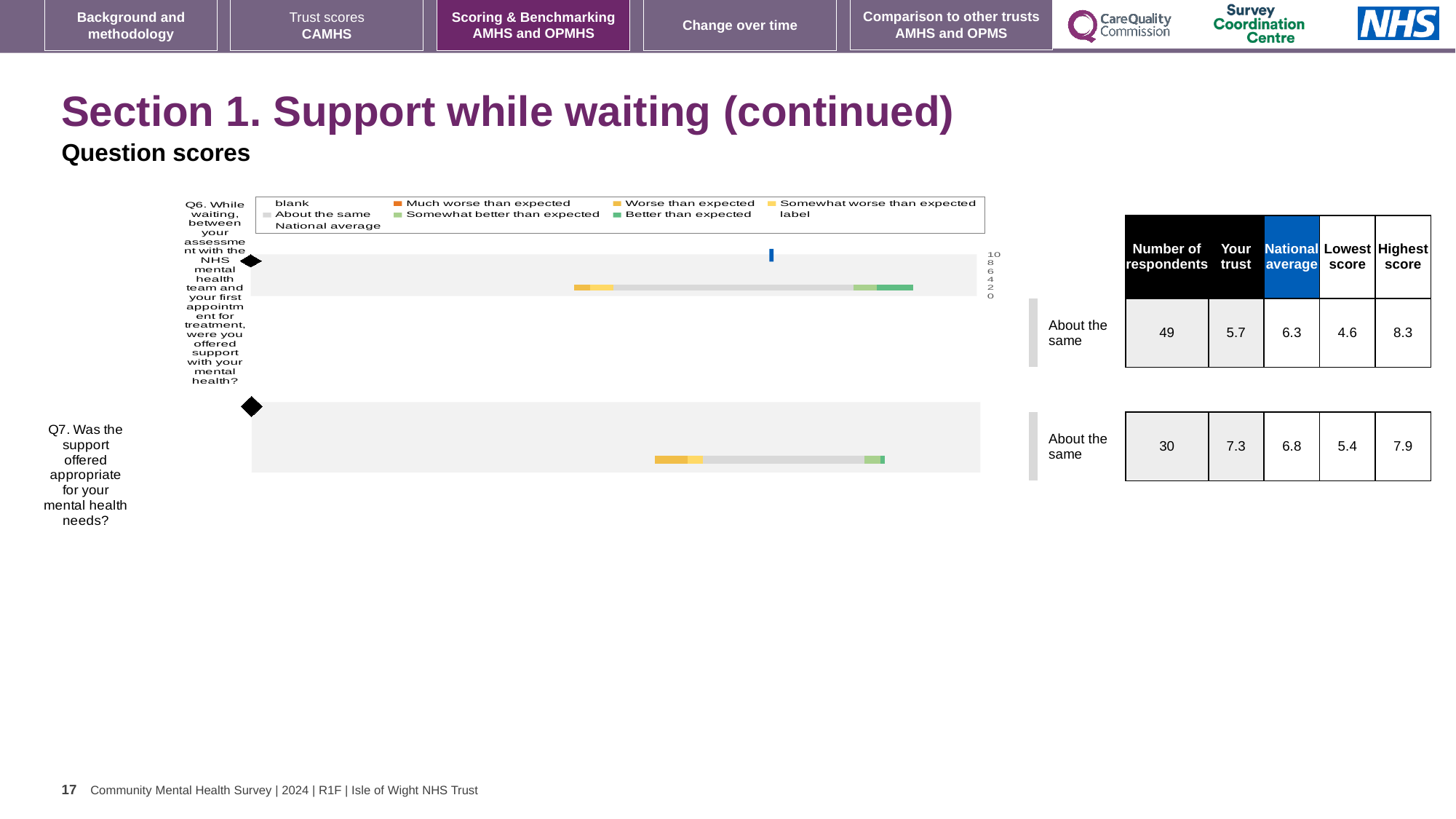
What is the highest score shown for Q6 in the table next to the chart? 8.3 Which question has the higher 'Your trust' score, Q6 or Q7? Q7 In the table next to the chart, what is the national average for Q6? 6.3 What is the difference between the 'Your trust' score and the national average for Q7? 0.5 What kind of chart is used to show the question scores for Q6 and Q7? bar chart How many respondents answered Q7 according to the table next to the chart? 30 How many questions are plotted in the question scores chart? 2 In the table next to the chart, what is the national average for Q7? 6.8 What benchmark category is given for both Q6 and Q7 next to the chart? About the same Which legend entry in the chart is shown in dark green? Better than expected In the table next to the chart, what is the 'Your trust' score for Q6? 5.7 In the table next to the chart, what is the 'Your trust' score for Q7? 7.3